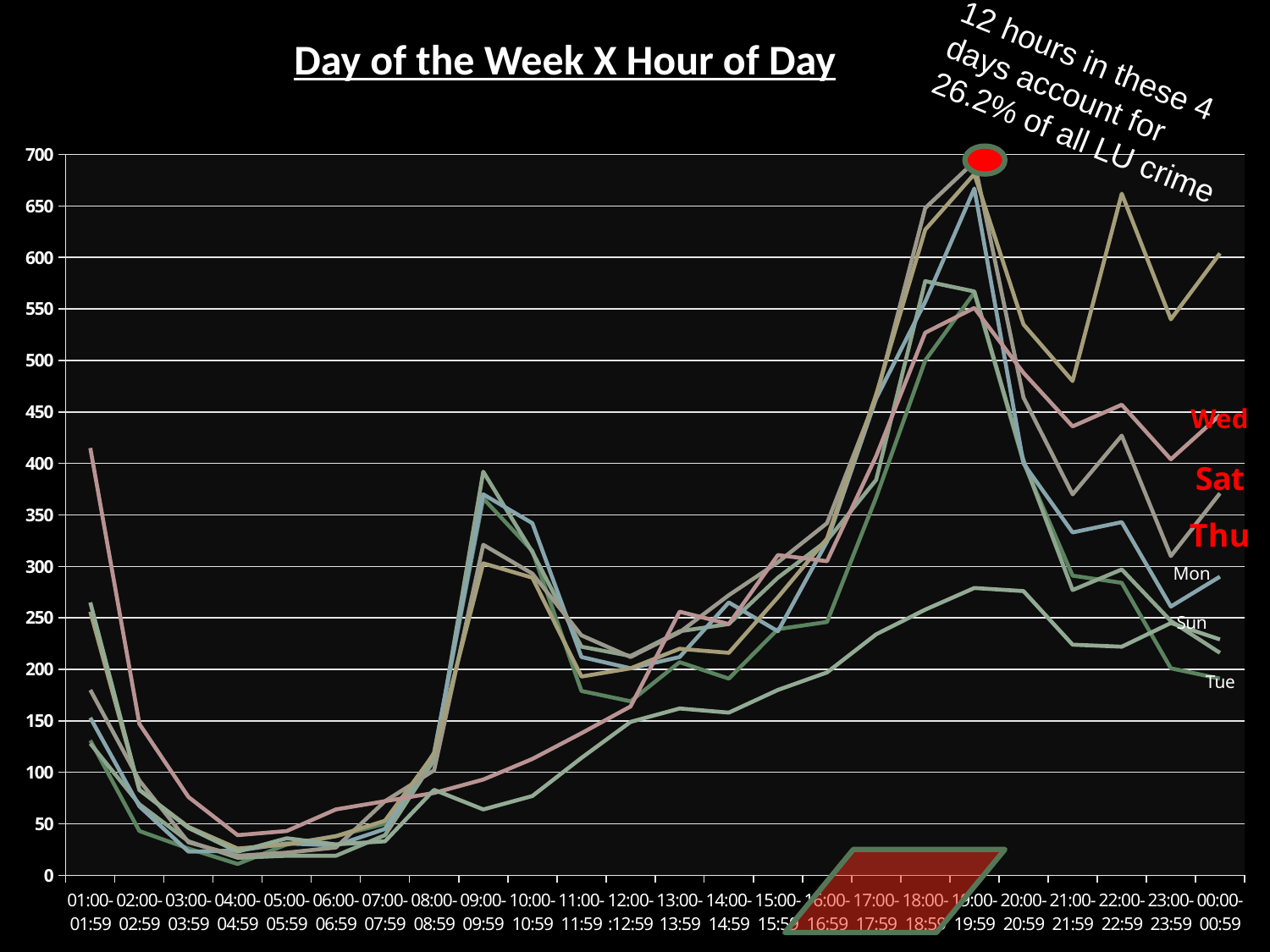
What is the maximum value shown on the y axis? 700 Do the values rise or fall from 15:00-15:59 to 19:00-19:59? rise What is the title of the chart? Day of the Week X Hour of Day Do the values rise or fall from 01:00-01:59 to 04:00-04:59? fall Is the highest value at 04:00-04:59 greater or less than 50? less According to the annotation, what percentage of all LU crime do the highlighted hours account for? 26.2% In which hour bin does the highest peak on the chart occur? 19:00-19:59 Is the highest value at 09:00-09:59 greater or less than 350? greater Which day labels on the chart are written in red? Wed, Sat, Thu Is the highest value on the chart greater or less than 650? greater How many hourly categories are shown along the x axis? 24 What kind of chart is shown on the slide? Line chart